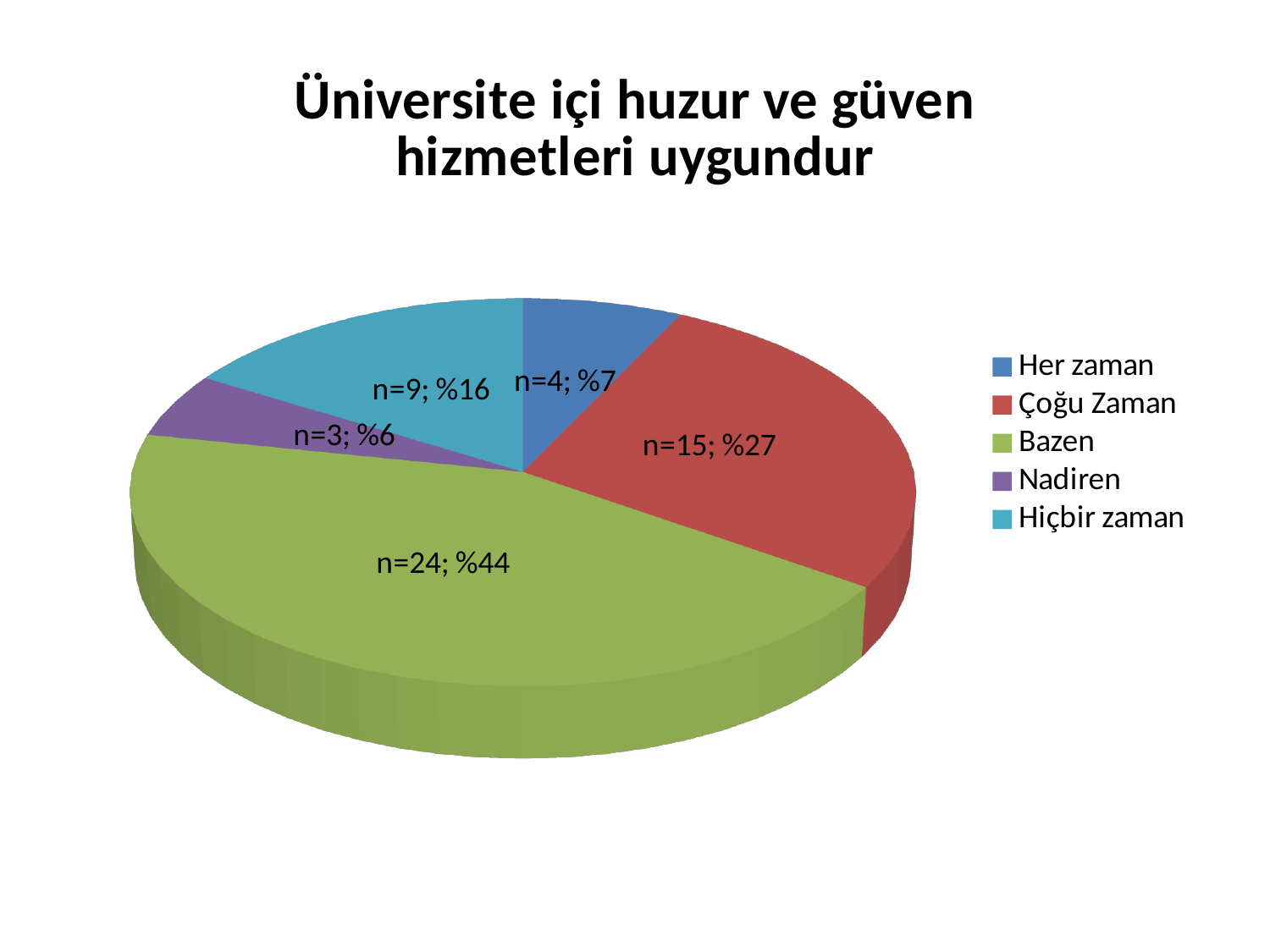
What is the count (n) for Her zaman? n=4 What is the difference in count between Bazen and Çoğu Zaman? 9 What is the title of the chart? Üniversite içi huzur ve güven hizmetleri uygundur What kind of chart is shown on the slide? pie chart What is the count (n) for Bazen? n=24 What colour is the Nadiren slice? purple Which has a larger count, Hiçbir zaman or Her zaman? Hiçbir zaman What percentage share does Hiçbir zaman have? %16 Which category has the smallest slice? Nadiren What percentage share does Çoğu Zaman have? %27 How many categories does the legend list? 5 Which category has the largest slice? Bazen